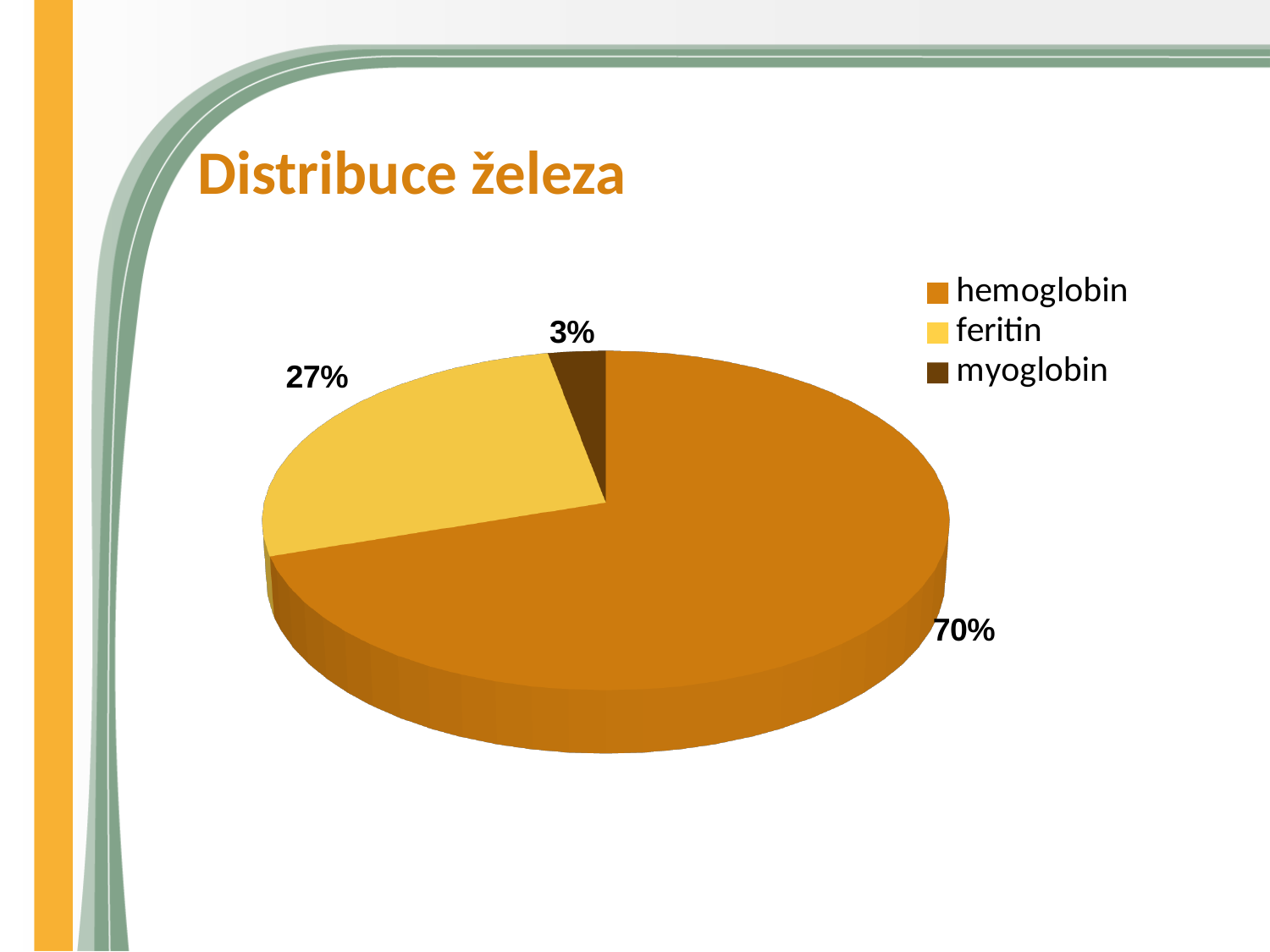
Which is larger, the feritin slice or the myoglobin slice? feritin What is the difference in percentage points between the feritin and myoglobin slices? 24 Which category is shown in the lightest yellow colour in the legend? feritin What is the title of the slide containing the chart? Distribuce železa What share of the pie does feritin account for? 27% Which category has the largest slice of the pie? hemoglobin How many categories are shown in the pie chart? 3 What kind of chart is shown on the slide? pie chart What share of the pie does hemoglobin account for? 70% Which category has the smallest slice of the pie? myoglobin What share of the pie does myoglobin account for? 3% What is the difference in percentage points between the hemoglobin and feritin slices? 43